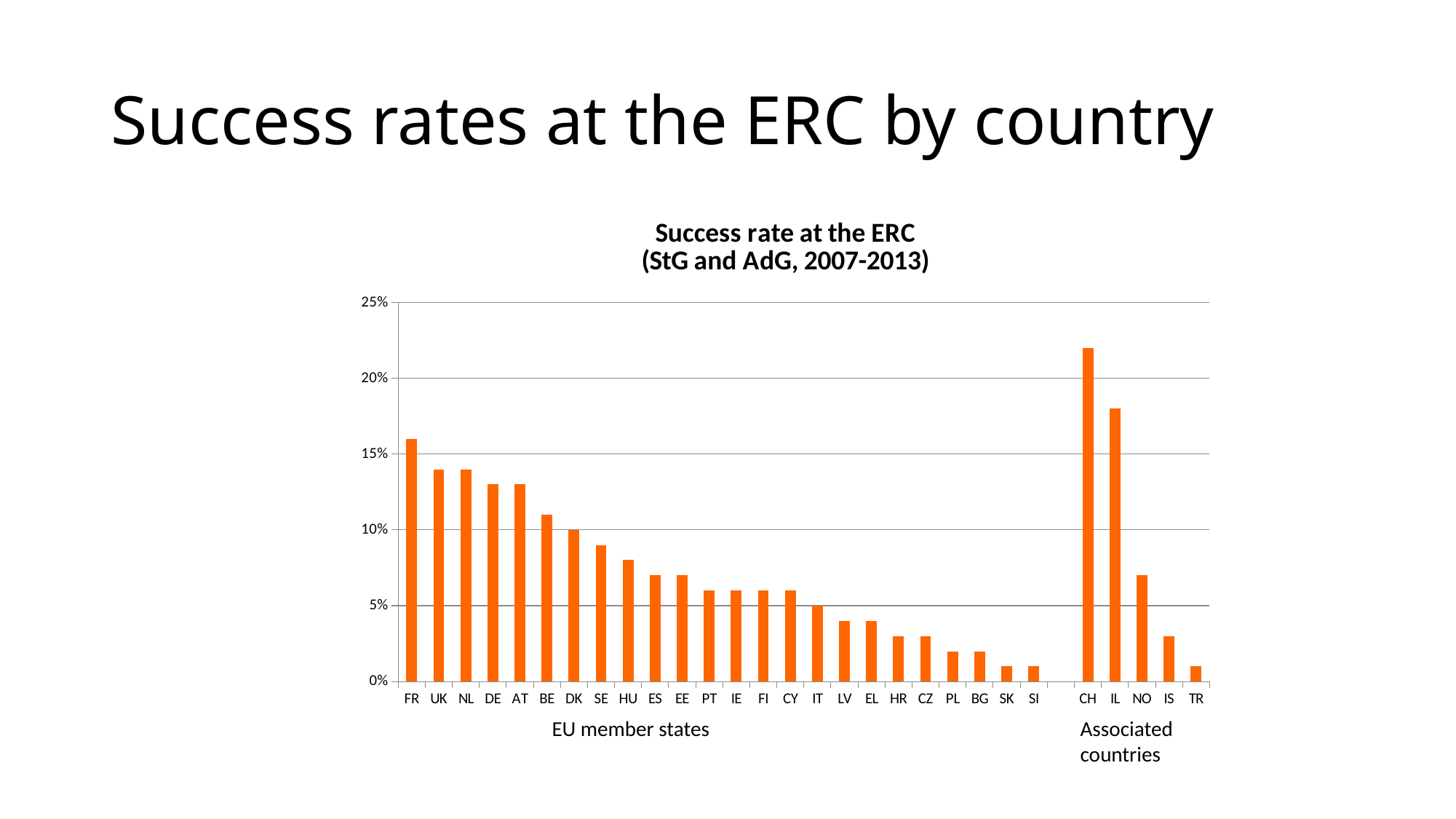
What is the success rate for IT? 5% Is the success rate for CH greater or less than 20%? greater Which country has the highest success rate in the chart? CH How many EU member states are shown in the chart? 24 What kind of chart is shown on the slide? Bar chart Which has a higher success rate, FR or CH? CH What is the title of the chart? Success rate at the ERC (StG and AdG, 2007-2013) What is the success rate for DK? 10% Do the success rates for the EU member states rise or fall from left to right? Fall Is the success rate for FR greater or less than 15%? greater Which EU member state has the highest success rate? FR Is the success rate for IL greater or less than 20%? less